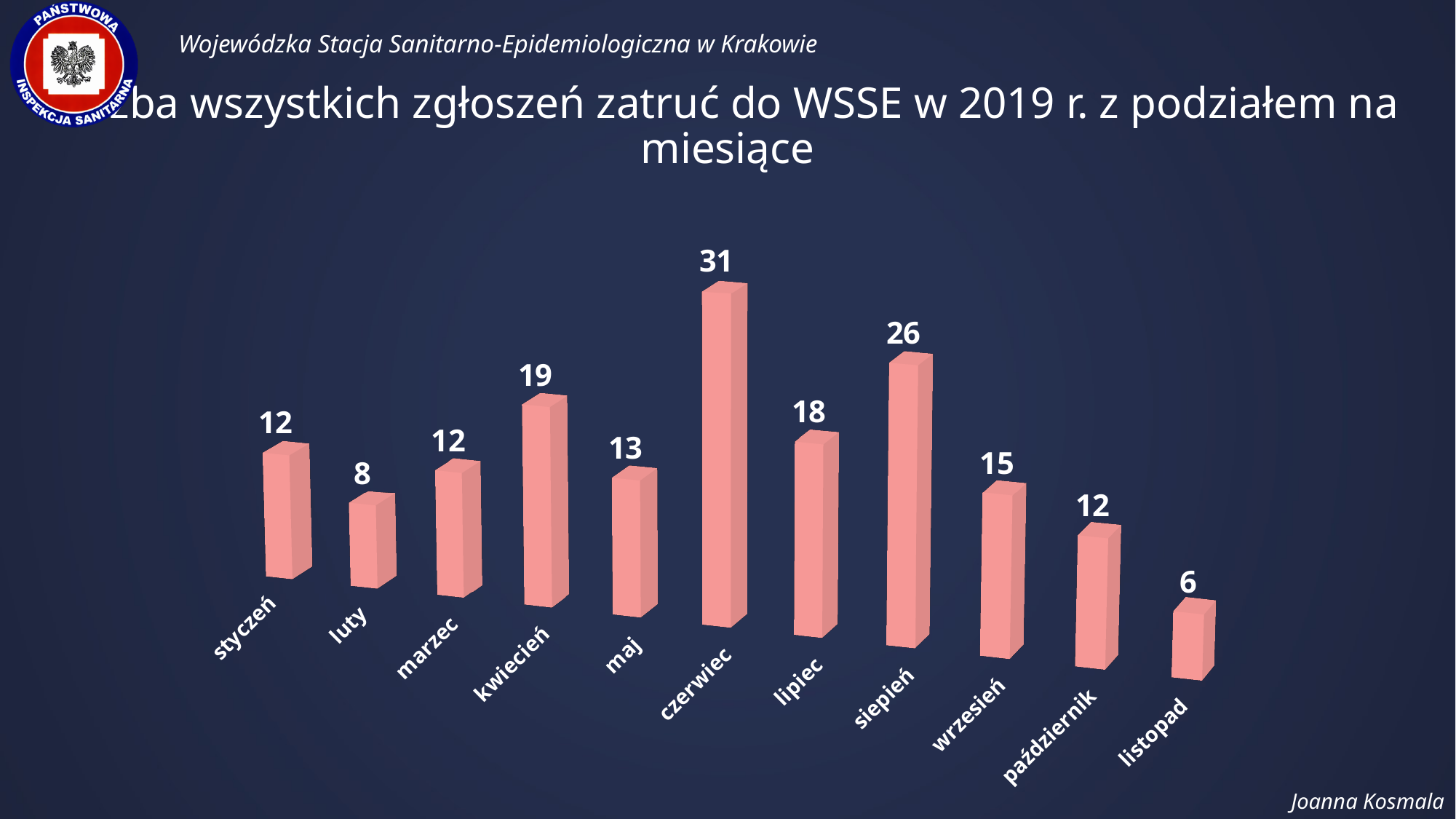
What is the value for czerwiec? 31 What is the value for sierpień? 26 What is the value for luty? 8 What is the difference between the values for kwiecień and maj? 6 What is the value for listopad? 6 How many months are shown on the chart? 11 Which is larger, the value for lipiec or the value for wrzesień? lipiec What kind of chart is shown on the slide? bar chart Which month has the lowest value? listopad What is the difference between the values for czerwiec and sierpień? 5 Which year does the chart title say the data refers to? 2019 Which month has the highest value? czerwiec